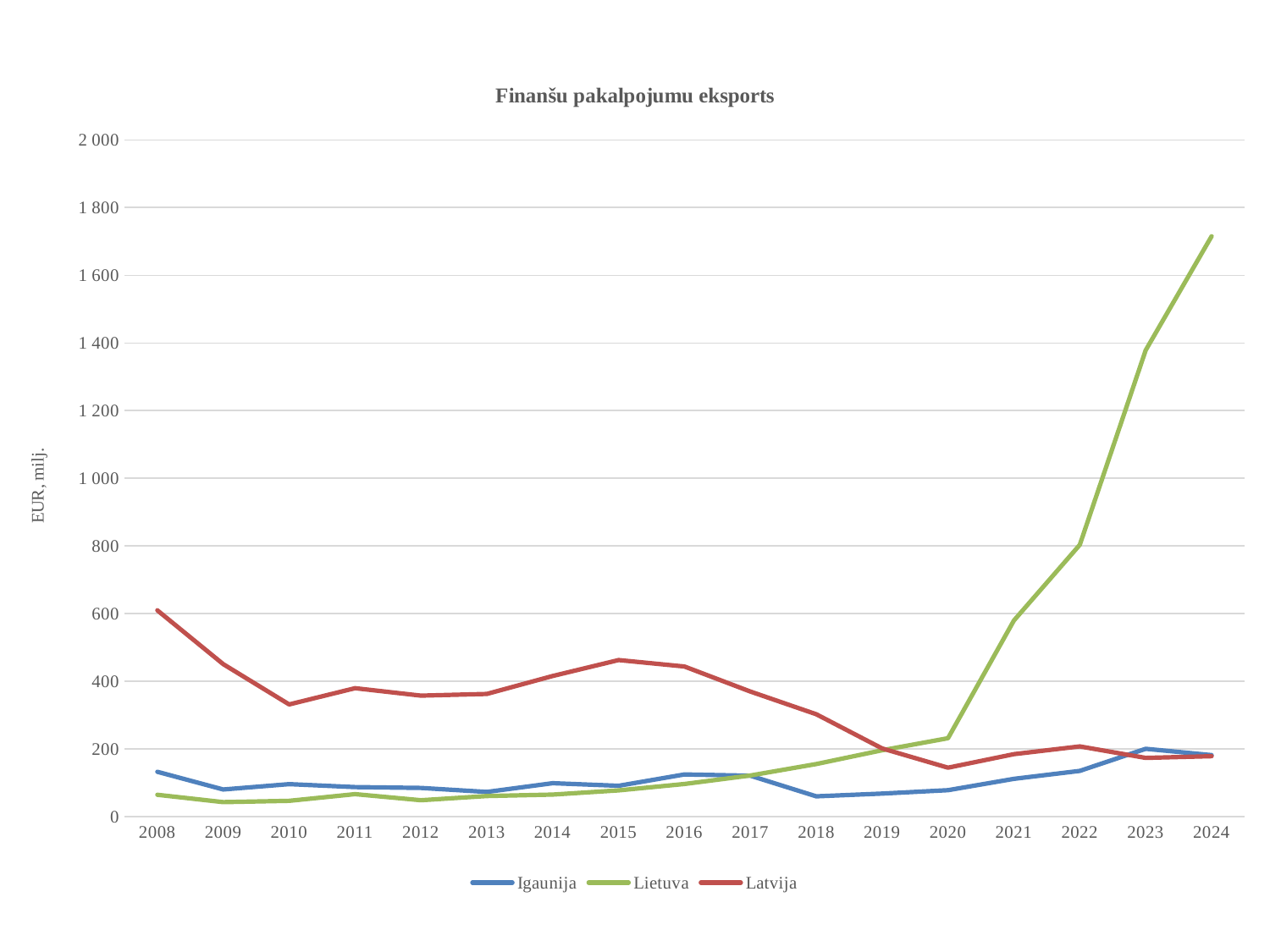
Does the Lietuva line rise or fall from 2020 to 2024? rise Which series has the lowest value in 2008? Lietuva How many years are shown on the x axis? 17 Which series has the highest value in 2024? Lietuva Is the value for Lietuva in 2022 greater or less than 600? greater Which series has the highest value in 2008? Latvija In 2015, which is larger: the value for Latvija or the value for Igaunija? Latvija How many series does the legend list? 3 What kind of chart is shown on the slide? line chart Is the value for Latvija in 2008 greater or less than 400? greater Is the value for Lietuva in 2020 greater or less than 400? less